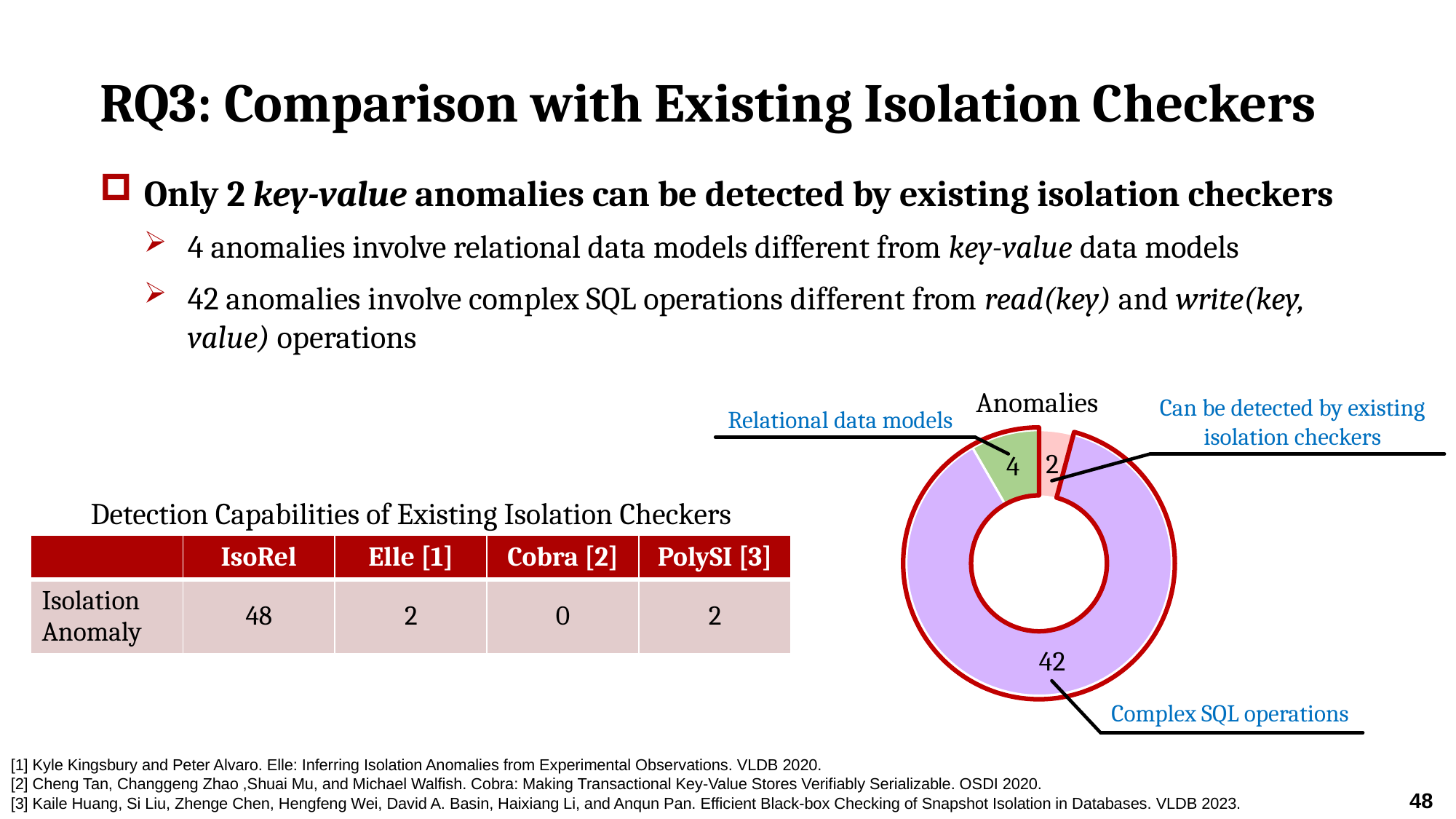
In the "Anomalies" chart, which is larger: the relational data models slice or the slice that can be detected by existing isolation checkers? Relational data models In the "Anomalies" chart, how many anomalies involve relational data models? 4 What is the total number of anomalies shown across all slices of the "Anomalies" chart? 48 Which slice of the "Anomalies" chart is the largest? Complex SQL operations What kind of chart is the "Anomalies" chart? doughnut chart In the "Anomalies" chart, how many anomalies involve complex SQL operations? 42 Which slice of the "Anomalies" chart is the smallest? Can be detected by existing isolation checkers What is the title of the chart on the slide? Anomalies In the "Anomalies" chart, what is the difference between the number of anomalies involving complex SQL operations and those involving relational data models? 38 In the "Anomalies" chart, how many anomalies can be detected by existing isolation checkers? 2 In the "Anomalies" chart, what colour is the slice for complex SQL operations? purple How many slices does the "Anomalies" chart have? 3